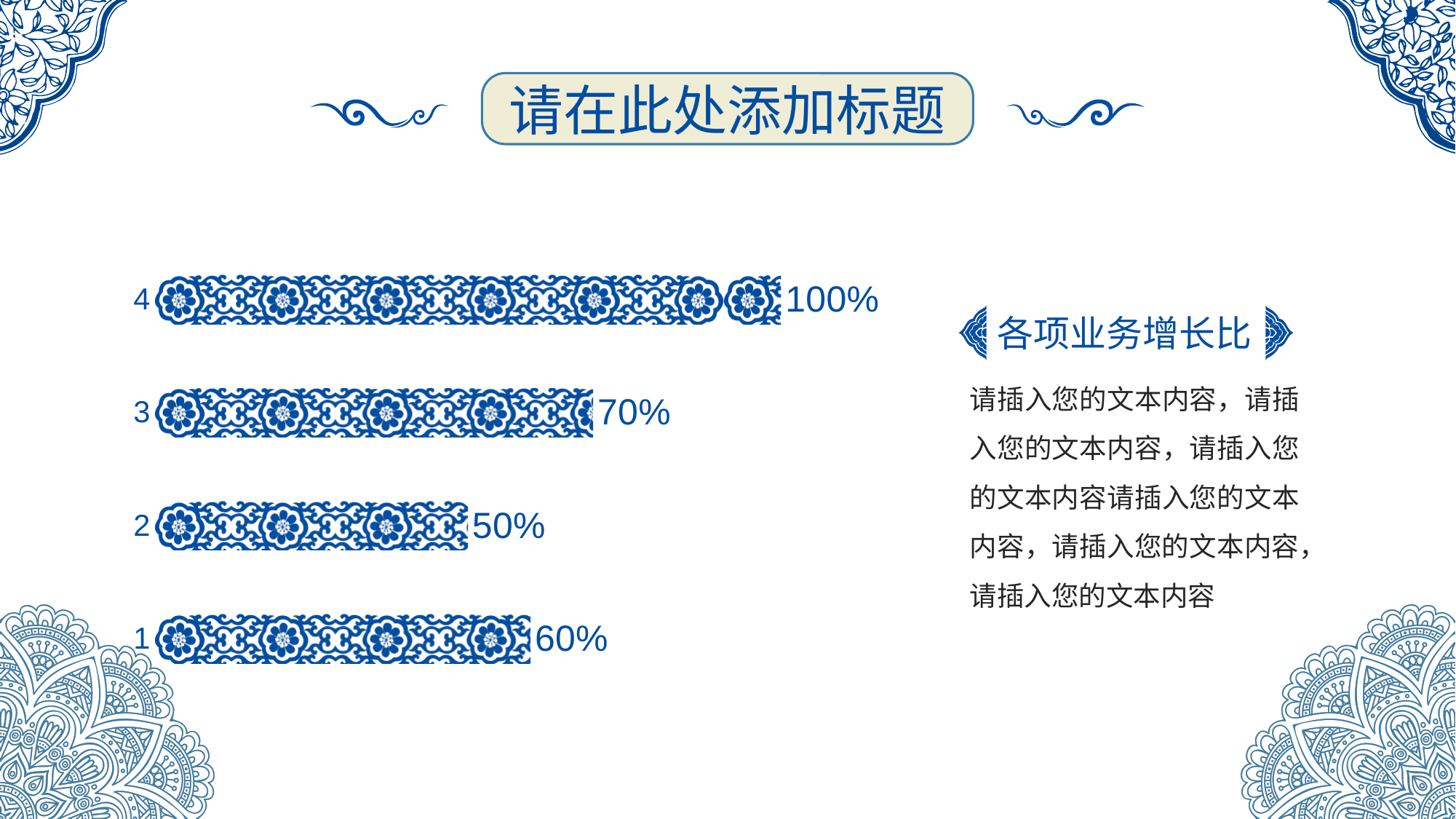
Which is larger, the value for category 1 or the value for category 3? category 3 What is the difference between the values for category 1 and category 2? 10% How many categories are shown in the chart? 4 What is the value for category 2? 50% What is the value for category 4? 100% What is the value for category 1? 60% What is the difference between the values for category 4 and category 3? 30% Which category has the highest value? 4 What kind of chart is shown on the slide? bar chart What is the value for category 3? 70% What is the heading shown to the right of the chart? 各项业务增长比 Which category has the lowest value? 2